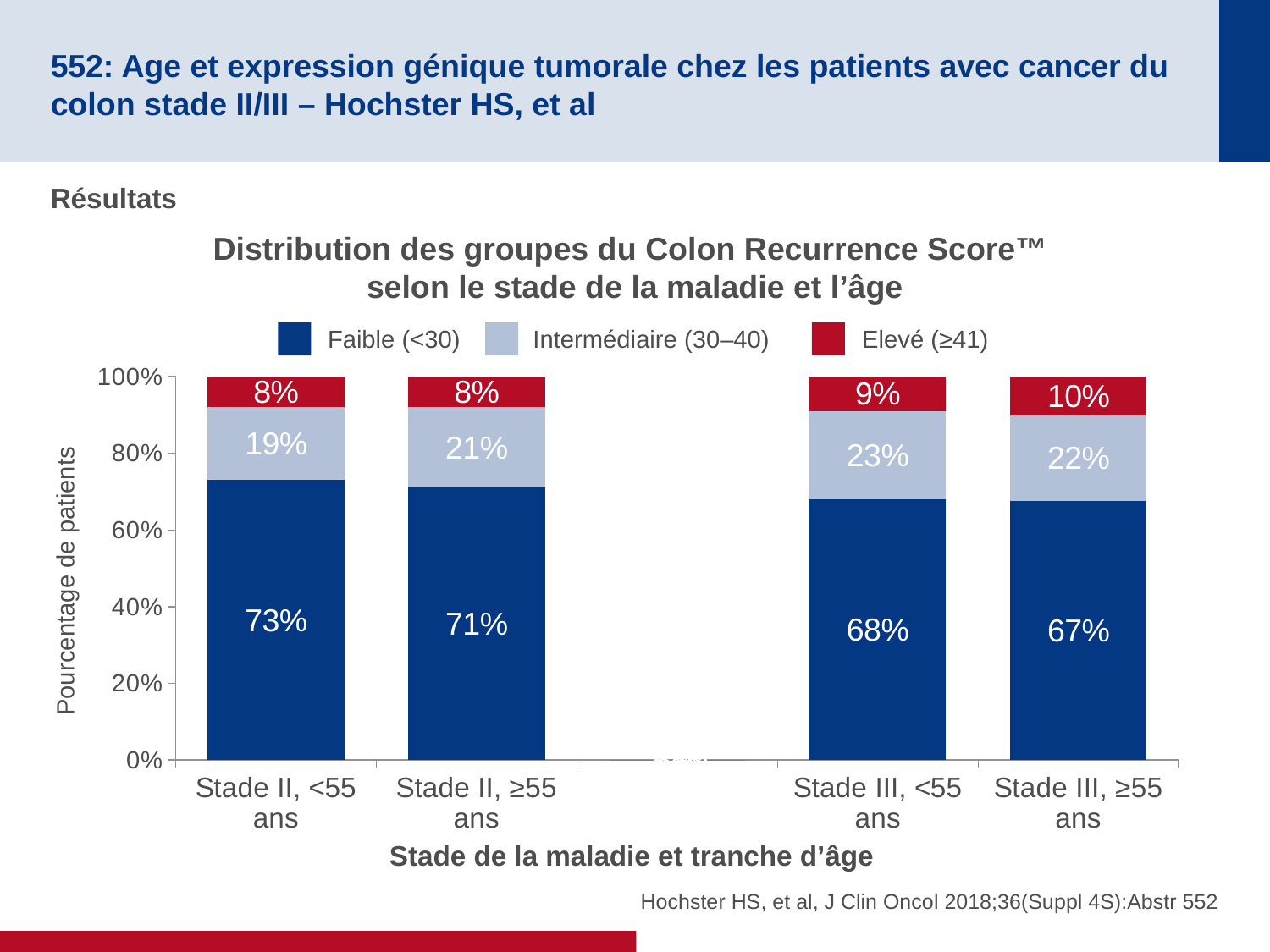
Which is larger, the Intermédiaire (30–40) value for Stade II, <55 ans or for Stade III, <55 ans? Stade III, <55 ans What kind of chart is shown? Stacked bar chart What is the difference between the Faible (<30) values for Stade II, <55 ans and Stade III, ≥55 ans? 6% What is the label of the y axis? Pourcentage de patients How many categories are shown on the x axis? 4 Which category has the highest Faible (<30) value? Stade II, <55 ans How many series does the legend list? 3 Which category has the lowest Faible (<30) value? Stade III, ≥55 ans What is the Faible (<30) value for Stade II, <55 ans? 73% What is the Intermédiaire (30–40) value for Stade III, <55 ans? 23% What is the Faible (<30) value for Stade II, ≥55 ans? 71% What is the Elevé (≥41) value for Stade III, ≥55 ans? 10%